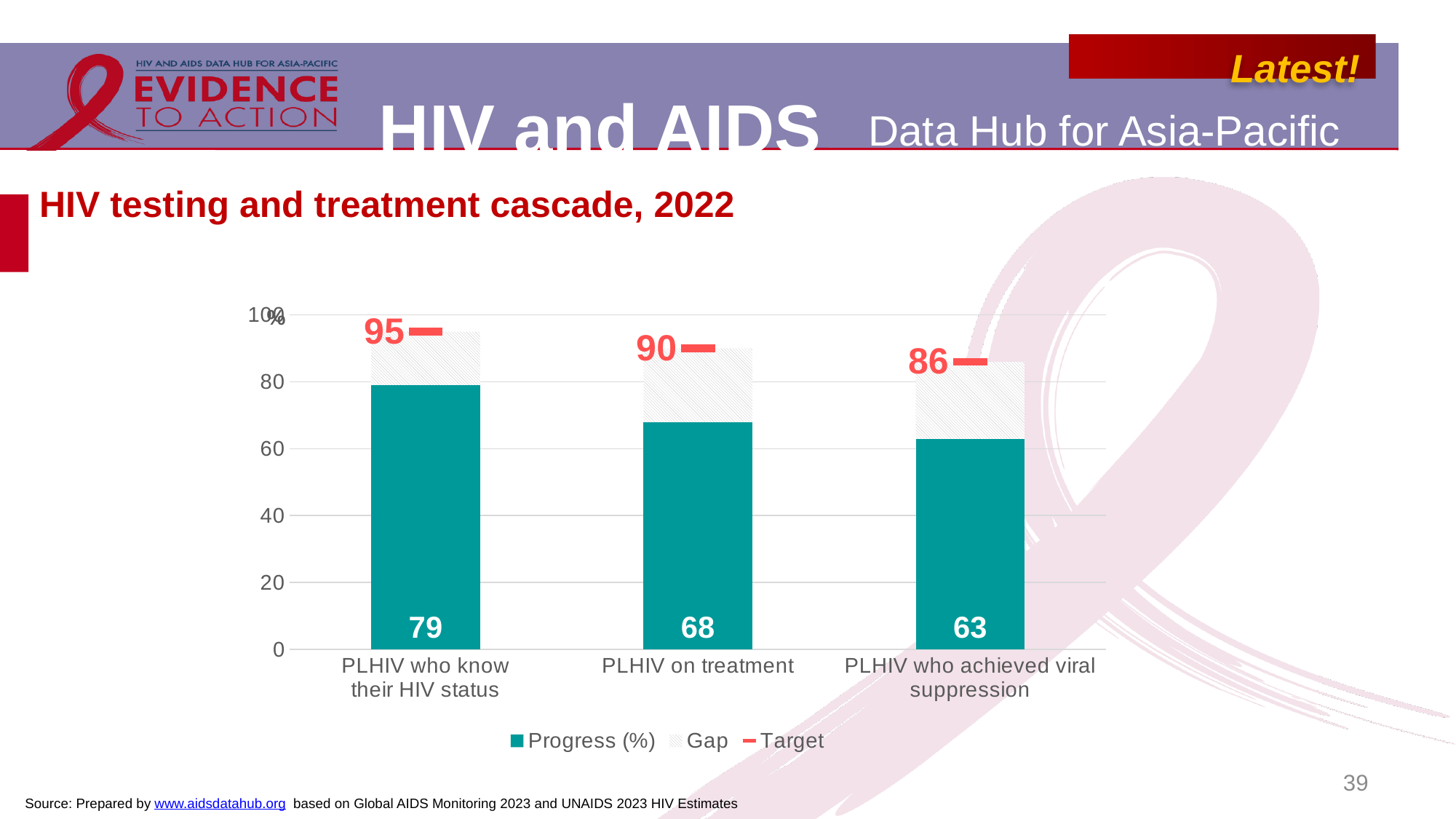
What is the Progress (%) value for PLHIV who achieved viral suppression? 63 Do the Progress (%) values rise or fall from left to right along the x axis? fall What is the Target value for PLHIV on treatment? 90 Which category has the lowest Progress (%) value? PLHIV who achieved viral suppression What is the Progress (%) value for PLHIV on treatment? 68 What is the difference between the Target and the Progress (%) value for PLHIV who know their HIV status? 16 What is the Target value for PLHIV who achieved viral suppression? 86 How many series does the legend list? 3 What is the Progress (%) value for PLHIV who know their HIV status? 79 Is the Progress (%) value for PLHIV on treatment greater or less than 60? greater Which category has the highest Progress (%) value? PLHIV who know their HIV status How many categories are shown on the x axis? 3